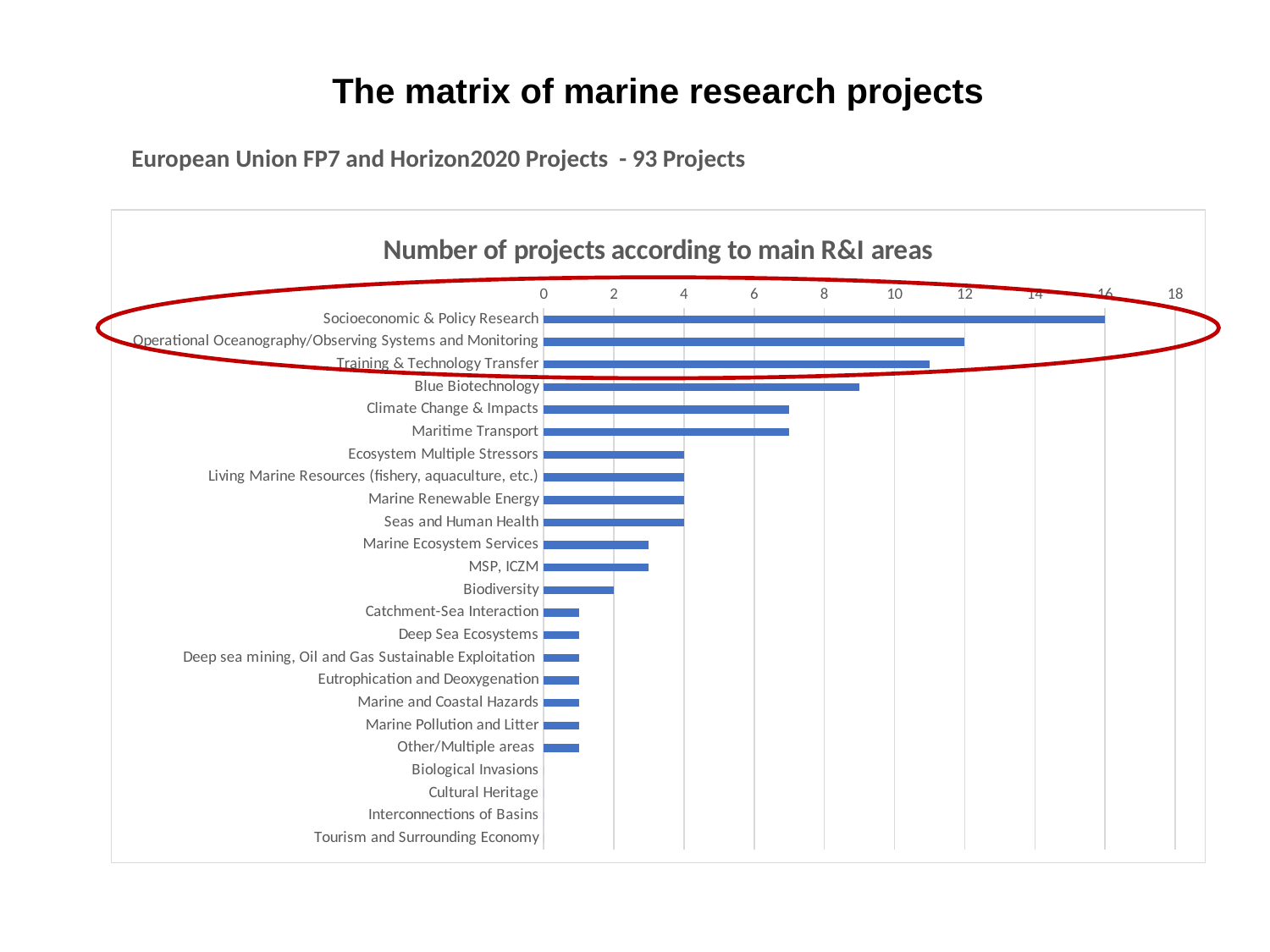
What kind of chart is shown on the slide? Bar chart How many projects are shown for Ecosystem Multiple Stressors? 4 How many R&I areas are listed on the chart? 24 Which has more projects, Blue Biotechnology or Climate Change & Impacts? Blue Biotechnology What is the difference in number of projects between Socioeconomic & Policy Research and Operational Oceanography/Observing Systems and Monitoring? 4 How many projects are shown for Biodiversity? 2 Is the value for Training & Technology Transfer greater or less than 10? greater How many projects are shown for Operational Oceanography/Observing Systems and Monitoring? 12 Which R&I area has the highest number of projects? Socioeconomic & Policy Research What is the title of the chart? Number of projects according to main R&I areas Is the value for Blue Biotechnology greater or less than 10? less How many projects are shown for Socioeconomic & Policy Research? 16